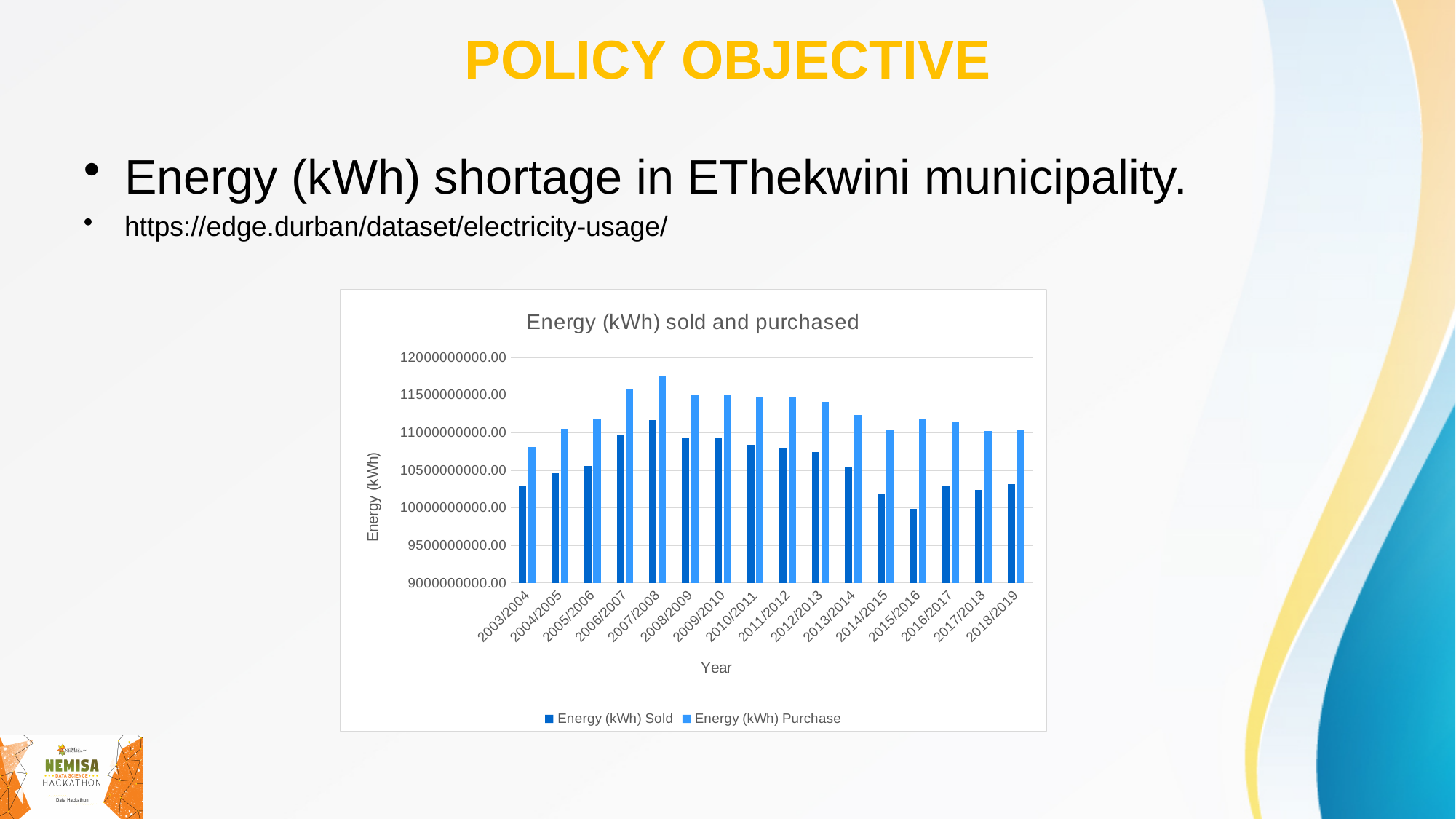
Which year has the lowest Energy (kWh) Sold value? 2015/2016 Does the Energy (kWh) Sold value rise or fall from 2003/2004 to 2007/2008? Rise What is the title of the chart? Energy (kWh) sold and purchased How many series does the chart's legend list? 2 In 2018/2019, which is larger: Energy (kWh) Sold or Energy (kWh) Purchase? Energy (kWh) Purchase Which year has the highest Energy (kWh) Sold value? 2007/2008 Which year has the lowest Energy (kWh) Purchase value? 2003/2004 Which year has the highest Energy (kWh) Purchase value? 2007/2008 What kind of chart is shown on the slide? Bar chart Is the Energy (kWh) Purchase value for 2007/2008 greater or less than 11500000000.00? greater How many years are shown on the x axis of the chart? 16